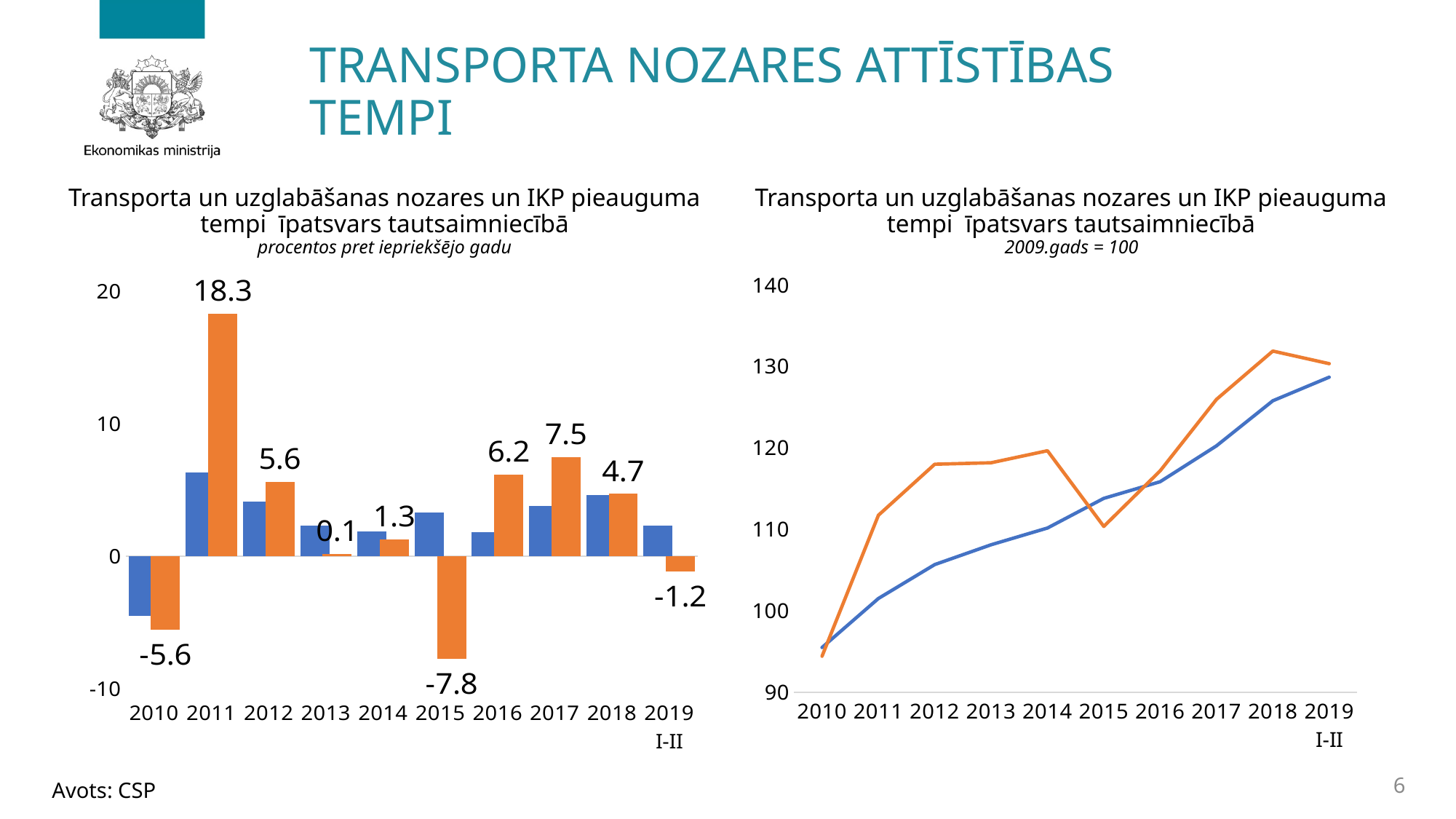
On the left bar chart, in which year does the orange series reach its lowest value? 2015 What kind of chart is the chart on the left of the slide? Bar chart What kind of chart is the chart on the right of the slide? Line chart On the left bar chart, in which year does the orange series reach its highest value? 2011 On the left bar chart, what is the labelled value of the orange bar for 2019 I-II? -1.2 On the right line chart, is the value of the blue line for 2018 greater or less than 120? greater On the left bar chart, what is the labelled value of the orange bar for 2015? -7.8 On the left bar chart, which year has the larger orange value, 2012 or 2018? 2012 How many year categories are shown on the x axis of the left bar chart? 10 On the left bar chart, what is the labelled value of the orange bar for 2011? 18.3 On the left bar chart, what is the difference between the orange values for 2017 and 2016? 1.3 On the right line chart, does the blue line generally rise or fall from 2010 to 2019 I-II? Rise